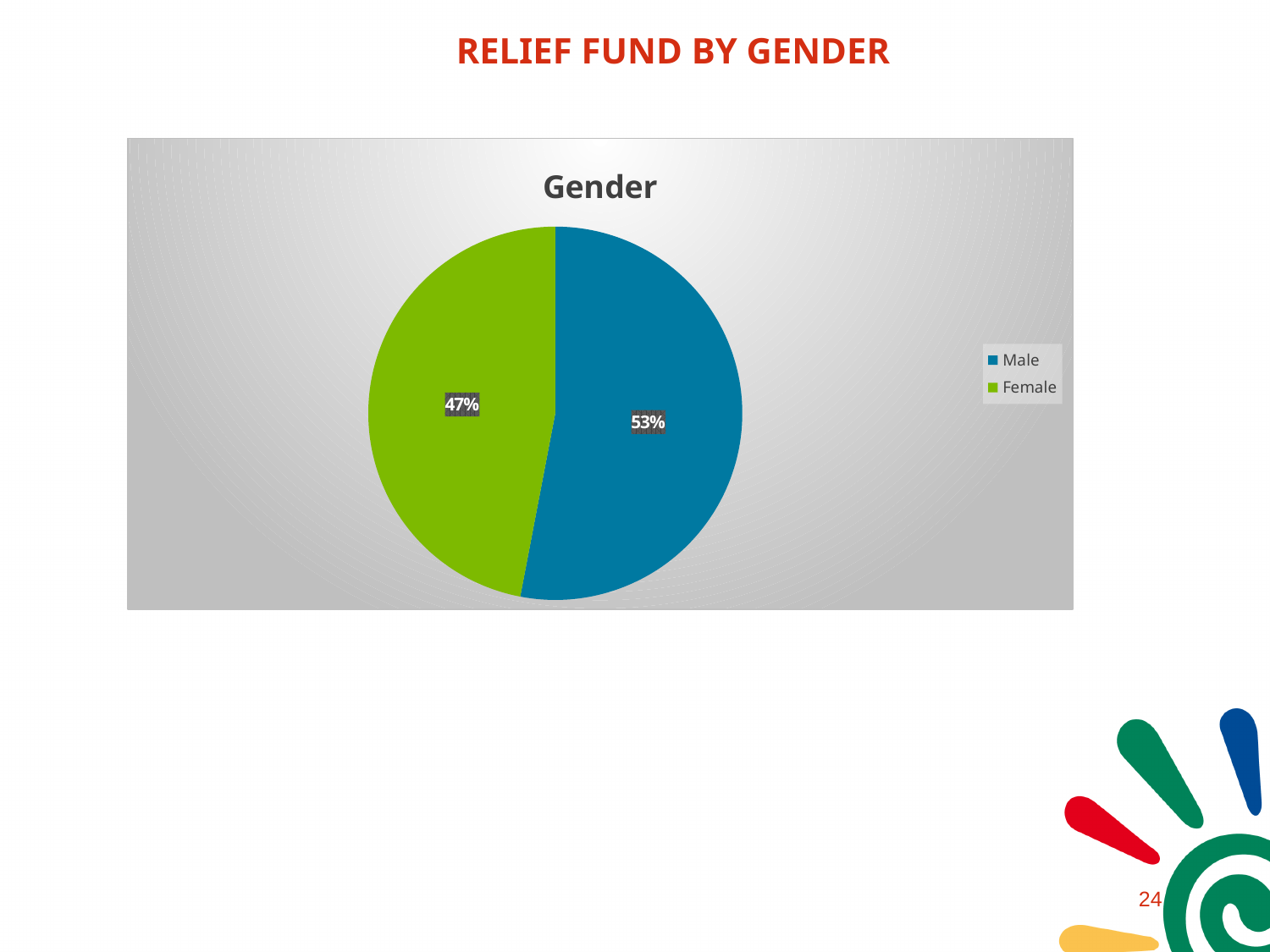
Which colour represents Female in the pie chart? green What is the difference in percentage points between the Male and Female shares? 6 What is the title of the chart? Gender What share of the relief fund goes to Female? 47% Is the Female share greater or less than 50%? less How many entries does the legend list? 2 How many slices does the pie chart have? 2 Is the Male share larger or smaller than the Female share? larger Which gender has the larger share of the relief fund? Male What share of the relief fund goes to Male? 53% Which gender has the smaller share of the relief fund? Female What kind of chart is shown on the slide? pie chart